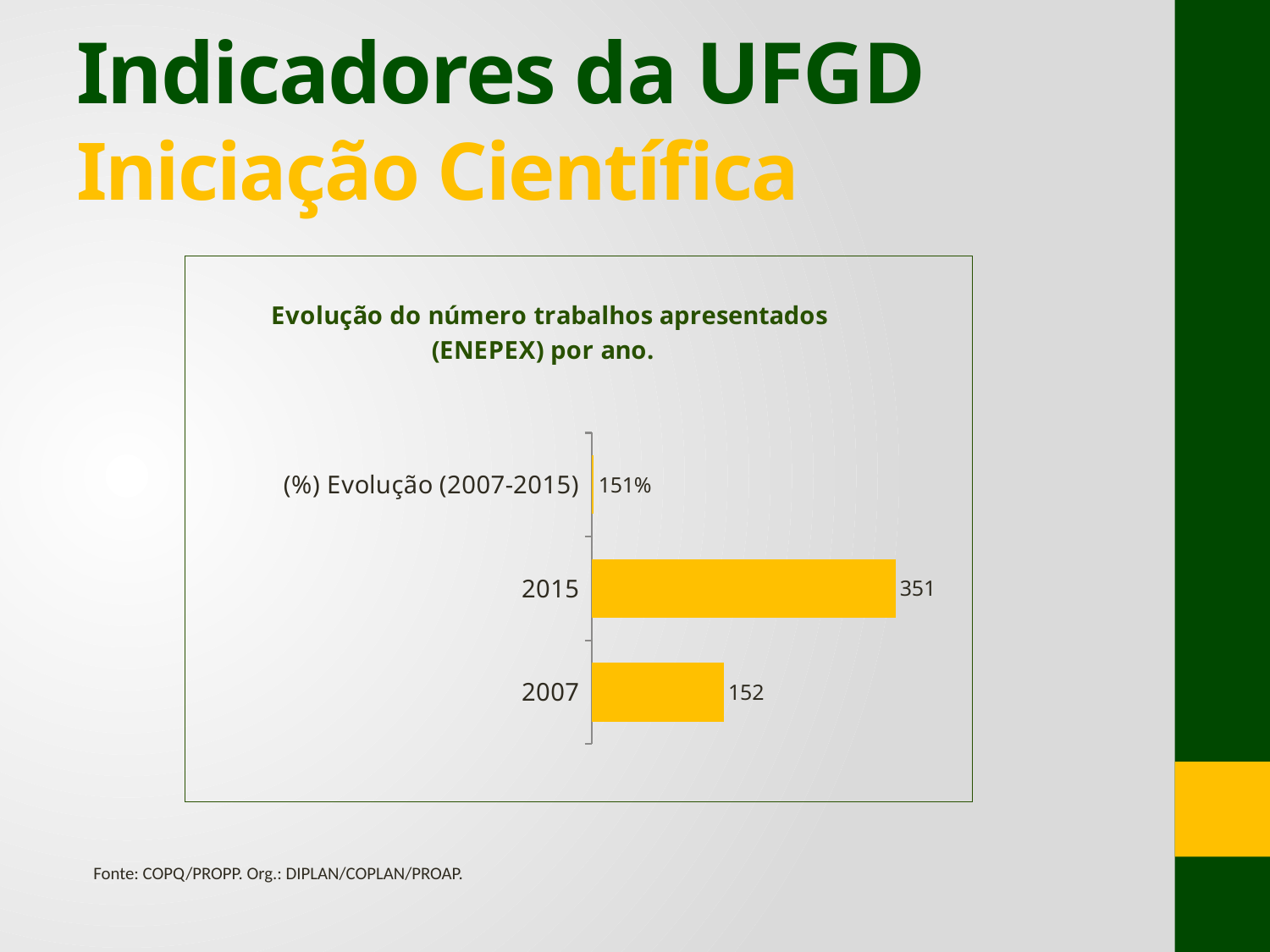
What is the difference between the values for 2015 and 2007? 199 What colour are the bars in the chart? Yellow Which year has the higher number of works presented, 2007 or 2015? 2015 What kind of chart is shown on the slide? Bar chart What is the title of the chart? Evolução do número trabalhos apresentados (ENEPEX) por ano. What is the value for 2007? 152 Which of the two years, 2007 or 2015, has the lowest value? 2007 How many categories are shown on the chart? 3 What is the value for 2015? 351 What is the value shown for (%) Evolução (2007-2015)? 151%